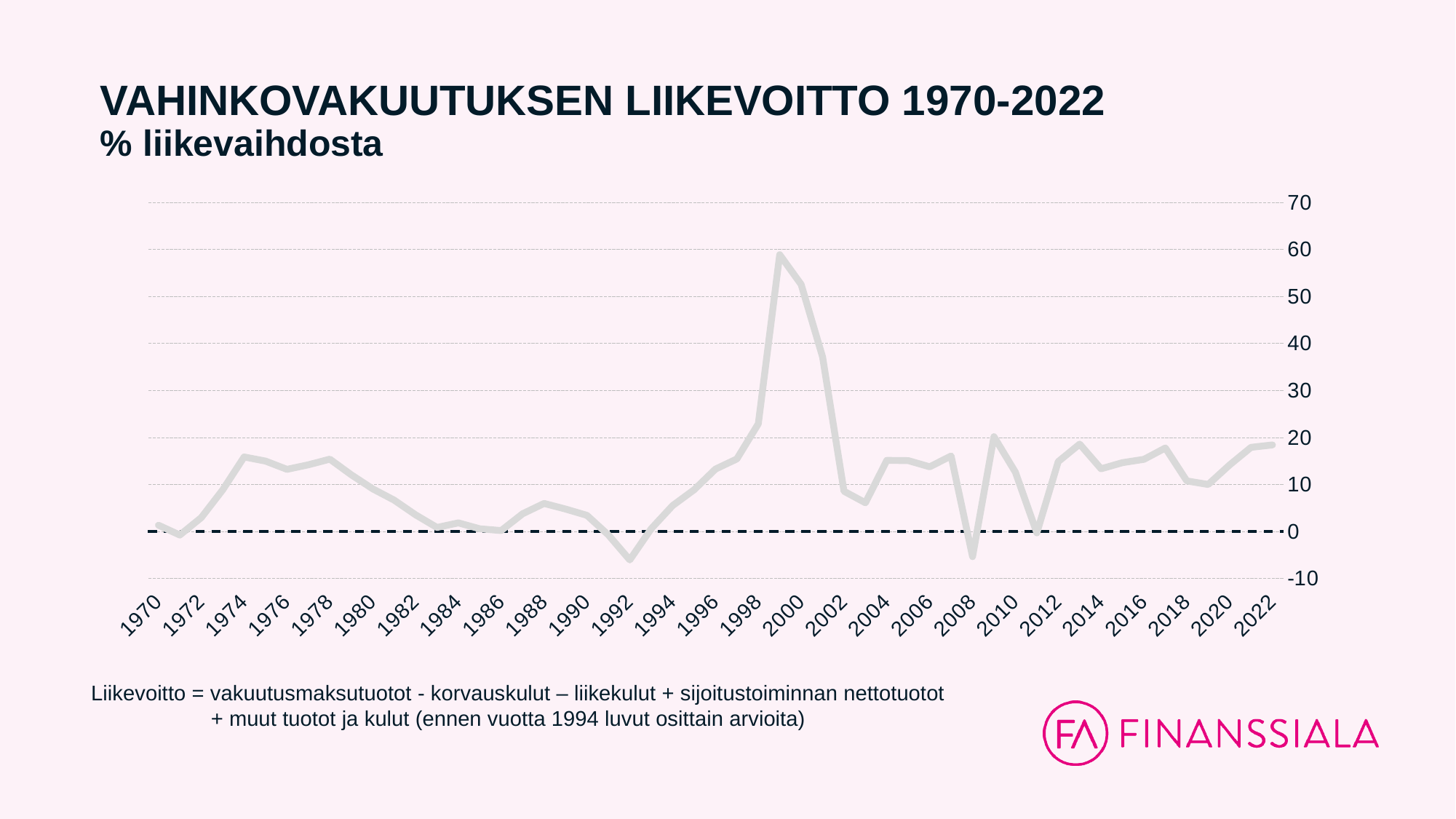
What kind of chart is shown on the slide? line chart Does the line rise or fall from 1999 to 2002? fall In which year does the line reach its highest value? 1999 Is the value for 1999 greater or less than 50? greater At what value is the horizontal dashed line drawn? 0 Is the value for 1992 greater or less than 0? less Is the value for 1970 greater or less than 10? less Which year has the larger value, 1999 or 2009? 1999 What is the title of the chart? VAHINKOVAKUUTUKSEN LIIKEVOITTO 1970-2022 Which year has the larger value, 1970 or 1974? 1974